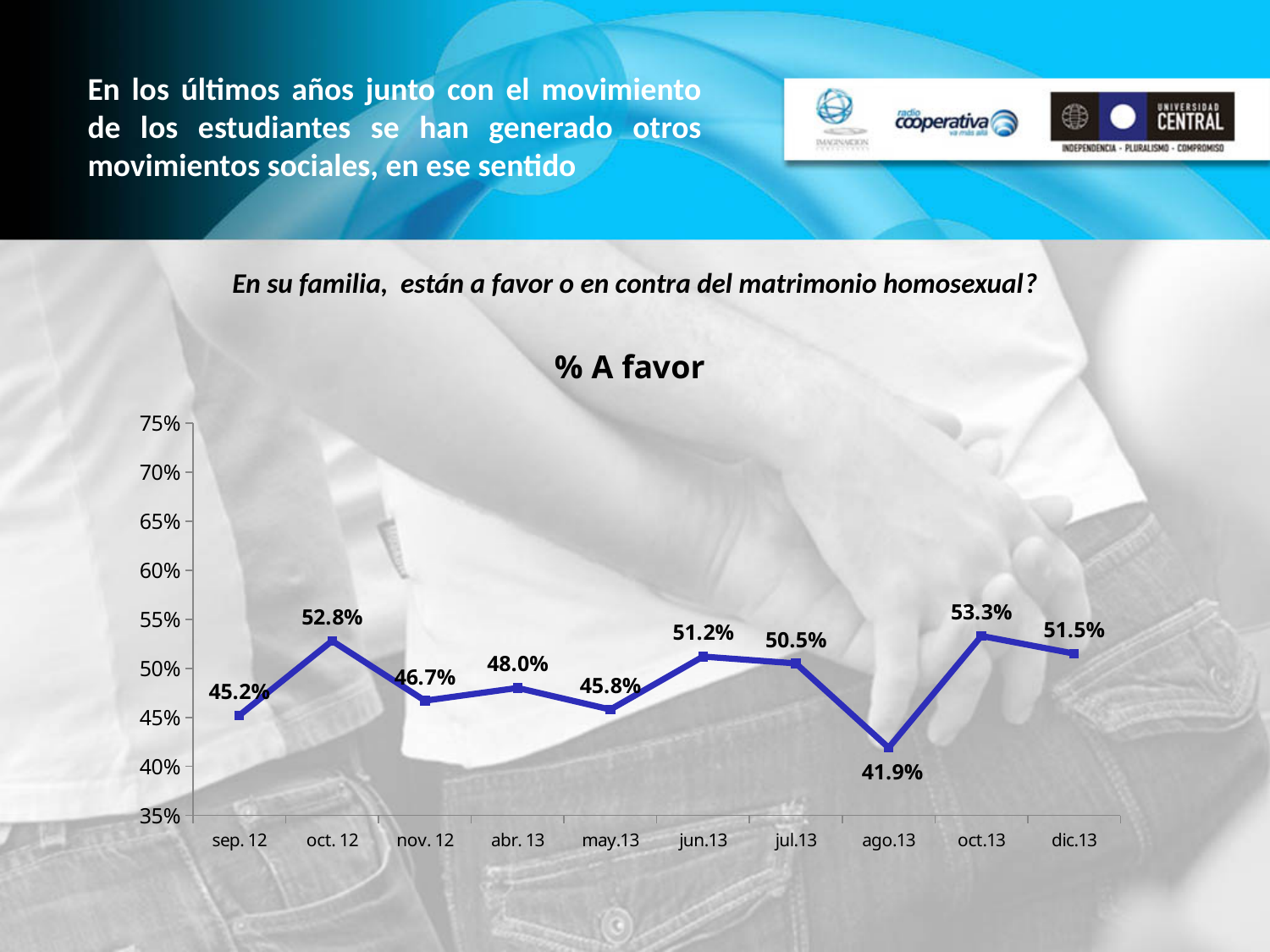
How many data points are plotted on the chart? 10 Which is larger, the value for jun.13 or the value for jul.13? jun.13 What is the value for oct. 12? 52.8% What is the title of the chart? % A favor What is the difference between the values for oct.13 and ago.13? 11.4% What kind of chart is shown on the slide? line chart Which category has the highest value? oct.13 What is the value for dic.13? 51.5% Is the value for sep. 12 greater or less than 50%? less Does the value rise or fall from ago.13 to oct.13? rise Which category has the lowest value? ago.13 What is the value for ago.13? 41.9%